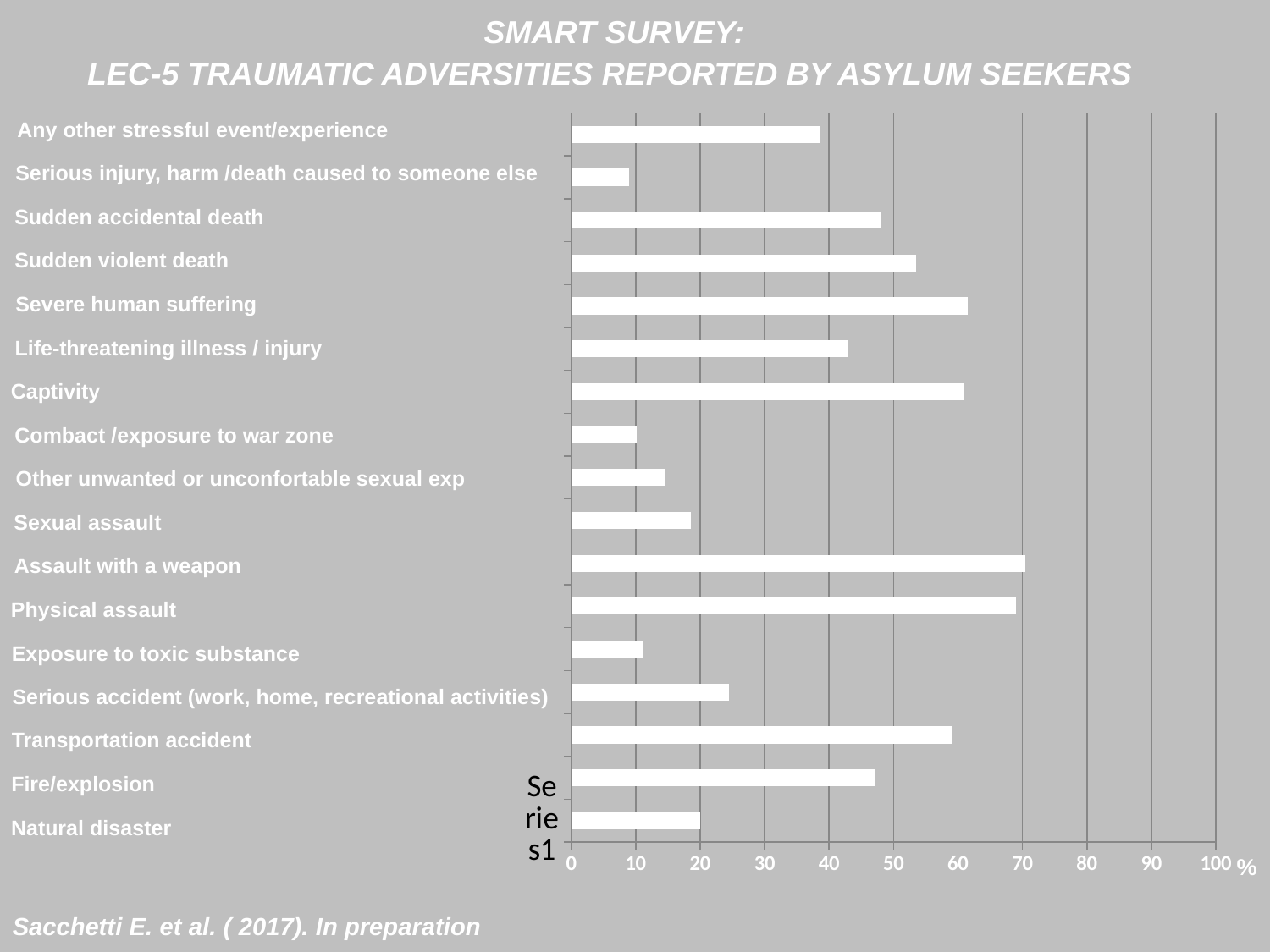
How many series does the chart legend list? 1 What kind of chart is shown on the slide? bar chart Is the value for Assault with a weapon greater or less than 60? greater Is the value for Transportation accident greater or less than 50? greater Which is larger, the value for Transportation accident or the value for Natural disaster? Transportation accident Is the value for Natural disaster greater or less than 30? less Which is larger, the value for Captivity or the value for Combact /exposure to war zone? Captivity How many traumatic adversity categories are plotted in the chart? 17 What unit is shown at the end of the horizontal axis? %